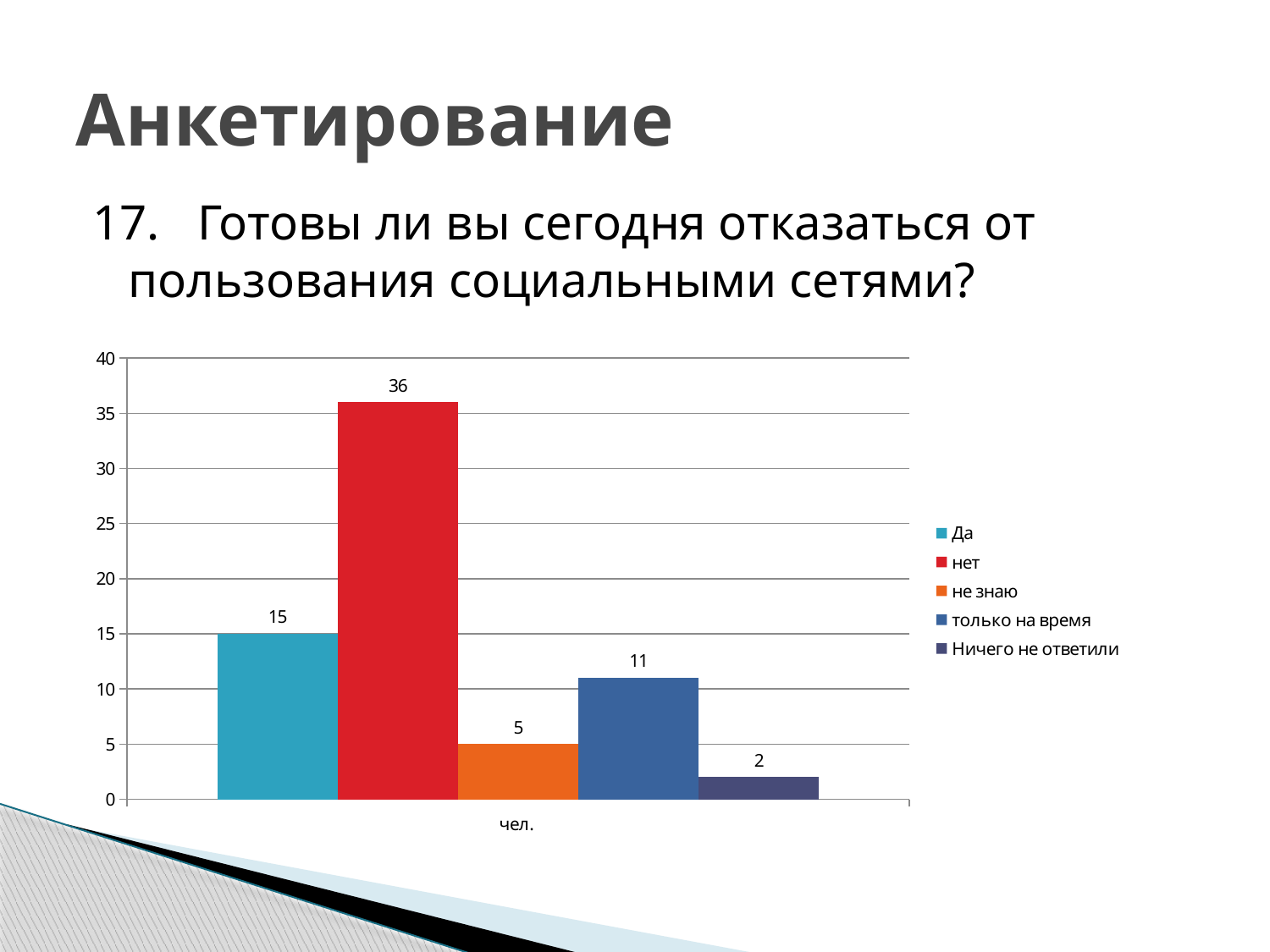
What is the value for "нет"? 36 Which is larger, the value for "только на время" or the value for "не знаю"? только на время How many series does the legend list? 5 What is the difference between the values for "нет" and "Да"? 21 Which series has the lowest value? Ничего не ответили What is the value for "только на время"? 11 Which series has the highest value? нет What is the label shown under the x axis of the chart? чел. What kind of chart is shown on the slide? bar chart What is the value for "Да"? 15 What is the value for "Ничего не ответили"? 2 What is the value for "не знаю"? 5